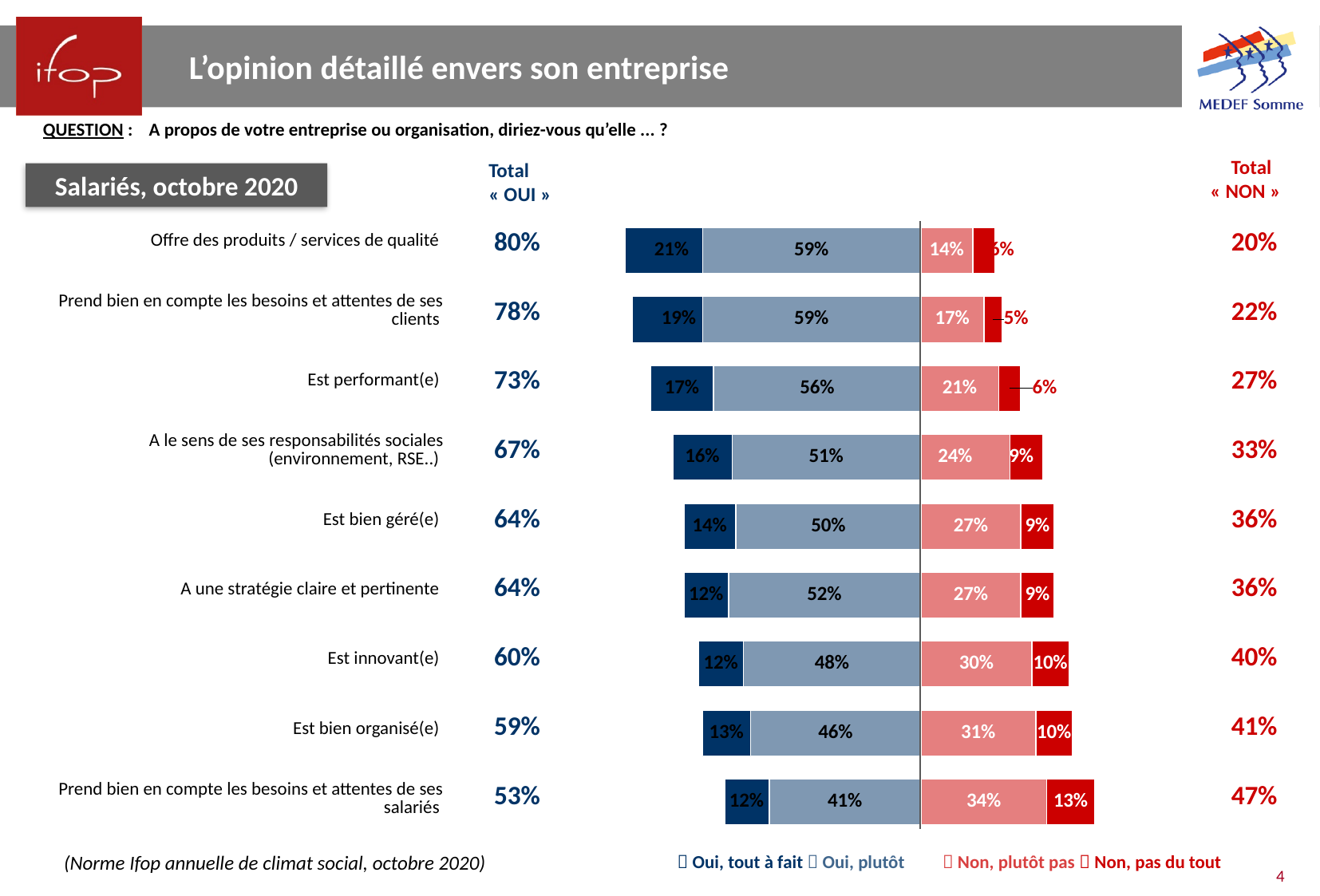
What is the value of "Non, plutôt pas" for "Est innovant(e)"? 30% Which item has the highest "Non, plutôt pas" value? Prend bien en compte les besoins et attentes de ses salariés How many items (categories) are shown in the chart? 9 Which has a larger "Oui, tout à fait" value: "Offre des produits / services de qualité" or "Est performant(e)"? Offre des produits / services de qualité What is the Total « OUI » for "Est bien géré(e)"? 64% Which item has the lowest Total « OUI »? Prend bien en compte les besoins et attentes de ses salariés What is the value of "Non, pas du tout" for "Prend bien en compte les besoins et attentes de ses salariés"? 13% How many series does the legend list? 4 What is the value of "Oui, plutôt" for "Est performant(e)"? 56% What kind of chart is shown on the slide? Stacked bar chart What is the difference between the Total « NON » for "Prend bien en compte les besoins et attentes de ses salariés" and for "Offre des produits / services de qualité"? 27 percentage points Which item has the highest Total « OUI »? Offre des produits / services de qualité